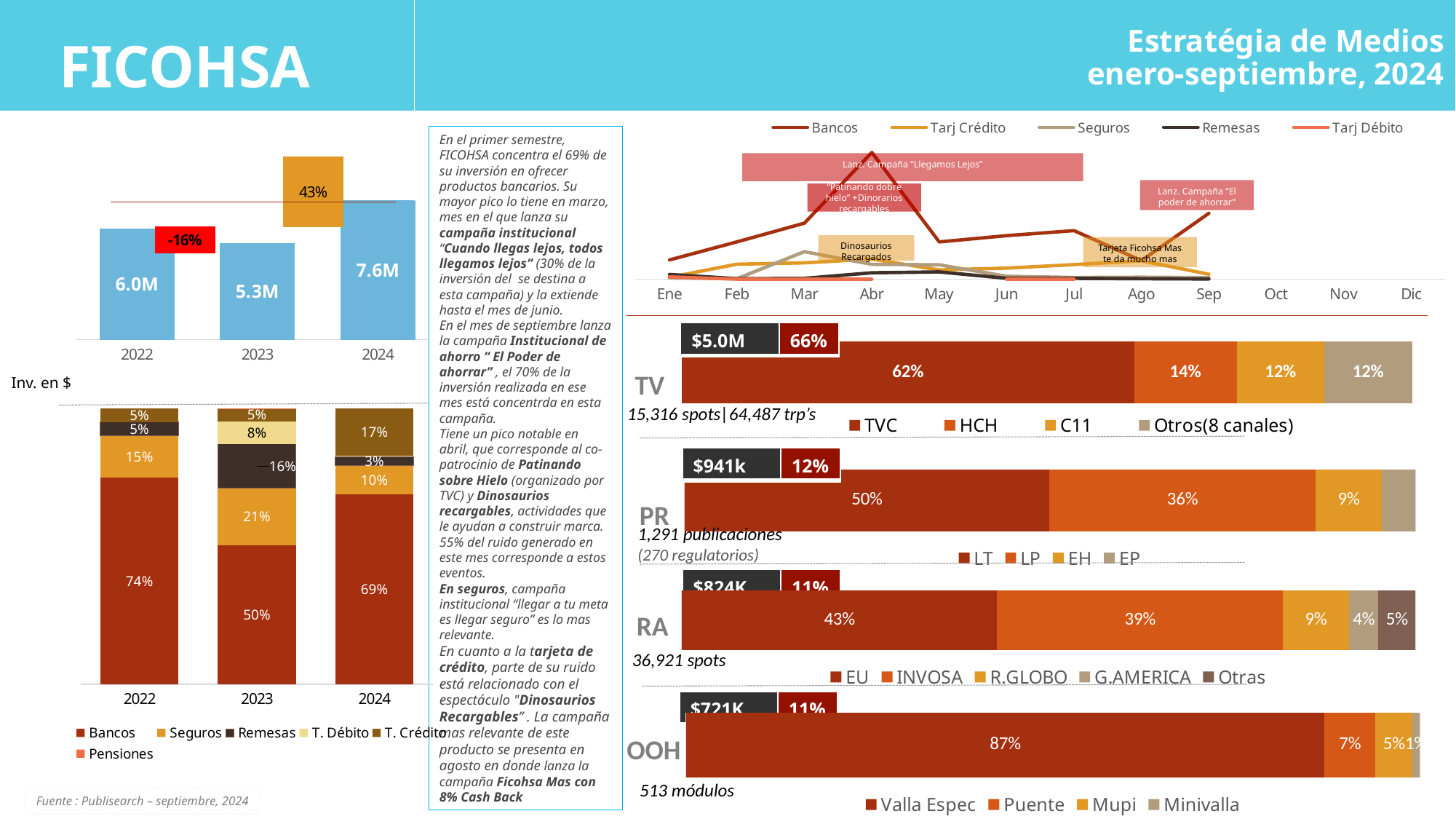
In the TV horizontal bar, what share does TVC have? 62% In the TV horizontal bar, what is the difference between the TVC share and the HCH share? 48% In the bottom-left stacked bar chart, what share does Bancos have in 2023? 50% In the OOH horizontal bar, what share does Valla Espec have? 87% In the bottom-left stacked bar chart, what share does T. Crédito have in 2024? 17% In the top-left bar chart of investment by year, what percentage change is shown between 2023 and 2024? 43% In the top-right line chart, how many series does the legend list? 5 In the top-left bar chart of investment by year, what is the value for 2024? 7.6M In the top-right line chart, in which month does the Bancos line reach its highest point? Abr In the top-left bar chart of investment by year, which year has the lowest investment? 2023 In the bottom-left stacked bar chart, how many series does the legend list? 6 In the RA horizontal bar, which is larger, EU or INVOSA? EU